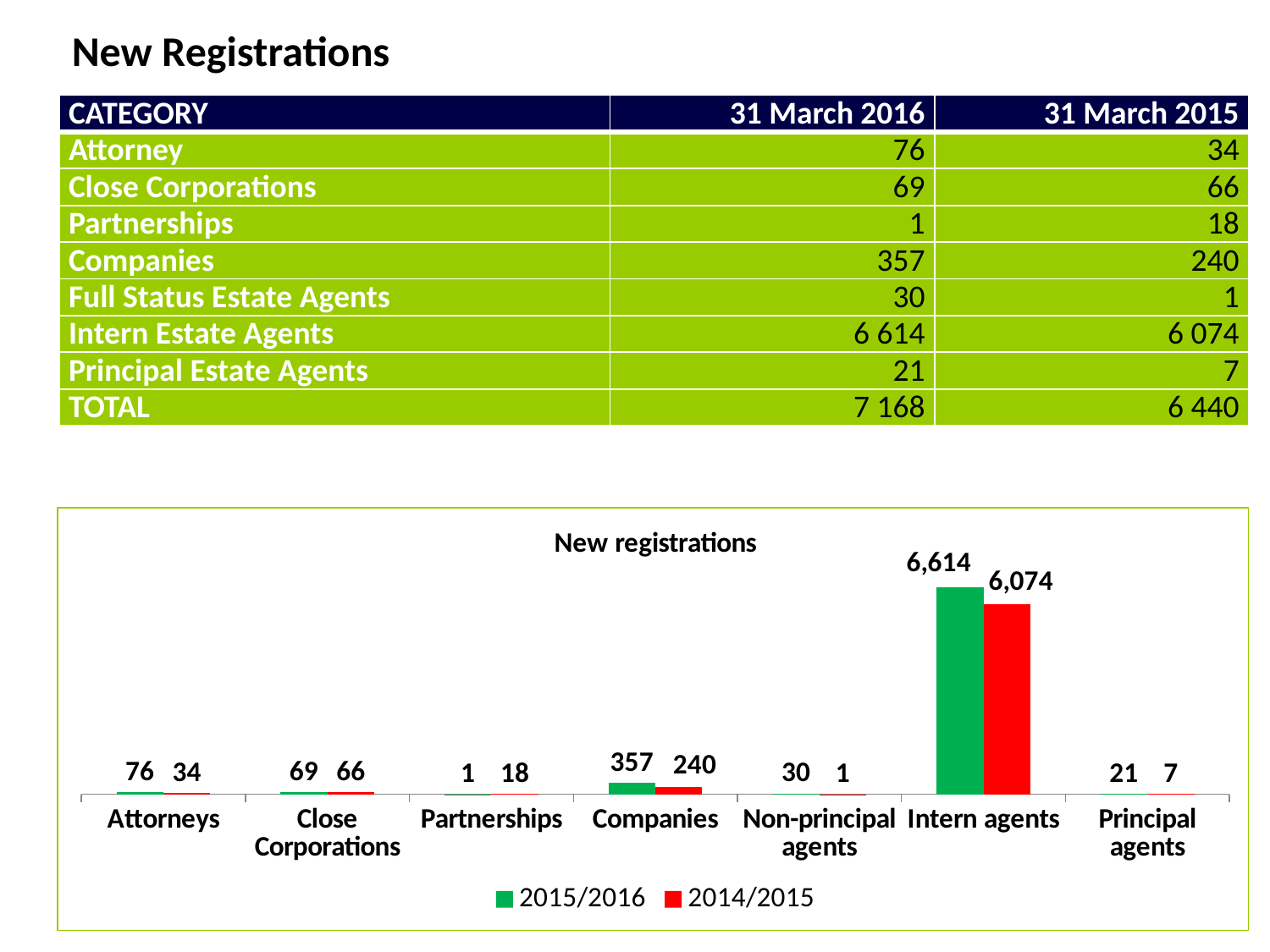
Which colour represents the 2014/2015 series in the New registrations chart? Red How many categories are shown on the x axis of the New registrations chart? 7 In the New registrations chart, which is larger for Partnerships: the 2015/2016 value or the 2014/2015 value? 2014/2015 What is the difference between the 2015/2016 and 2014/2015 values for Attorneys in the New registrations chart? 42 What is the 2015/2016 value for Intern agents in the New registrations chart? 6,614 What is the 2014/2015 value for Companies in the New registrations chart? 240 Which category has the lowest 2015/2016 value in the New registrations chart? Partnerships How many series does the legend of the New registrations chart list? 2 Which category has the highest 2015/2016 value in the New registrations chart? Intern agents What is the 2015/2016 value for Non-principal agents in the New registrations chart? 30 What is the difference between the 2015/2016 and 2014/2015 values for Intern agents in the New registrations chart? 540 What kind of chart is the New registrations chart? Bar chart